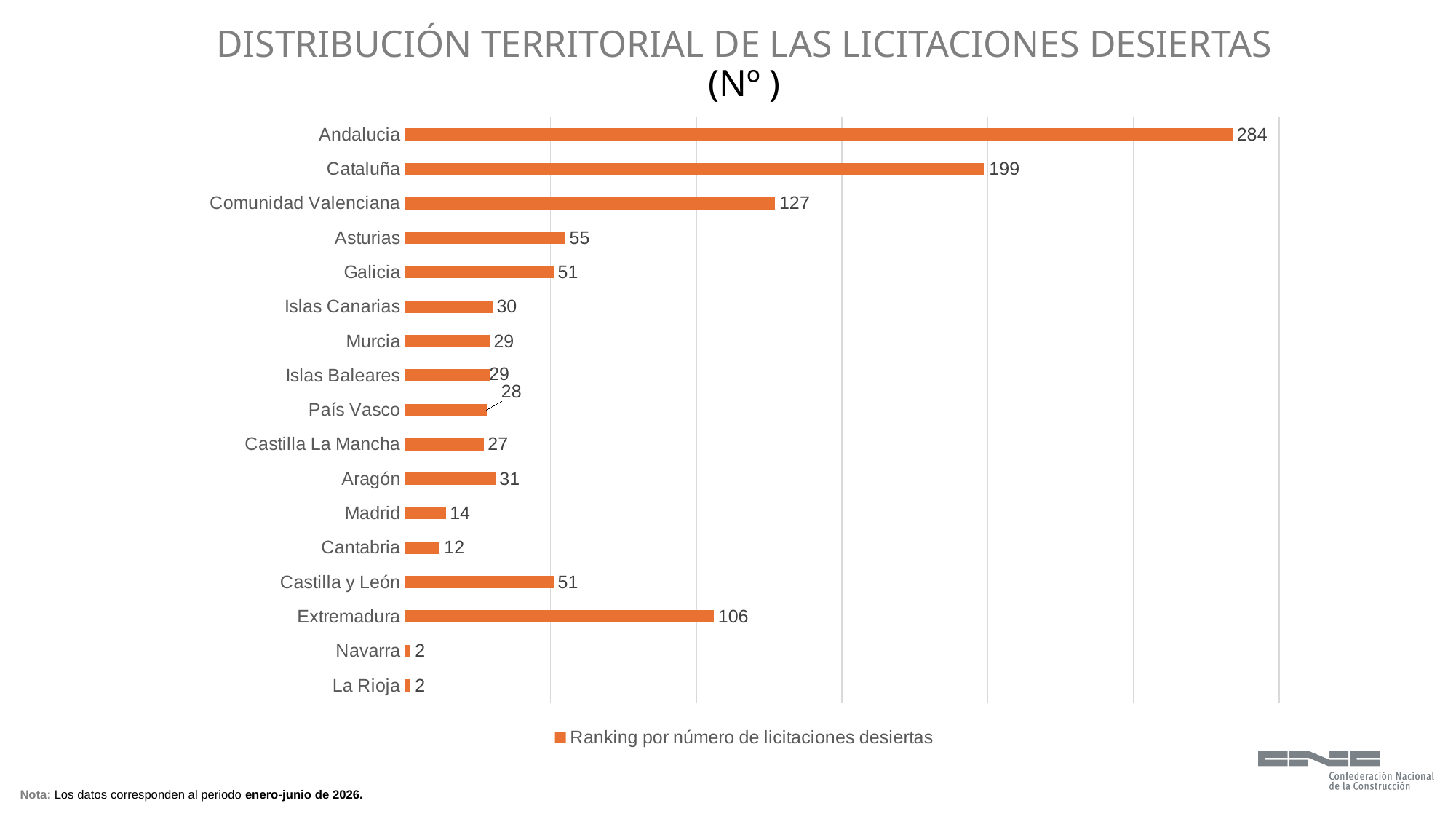
What is the value for Comunidad Valenciana? 127 What is the difference between the values for Extremadura and Asturias? 51 How many series does the legend list? 1 What kind of chart is shown on the slide? bar chart What is the value for País Vasco? 28 Which is larger, the value for Aragón or the value for Islas Canarias? Aragón Which region has the highest number of licitaciones desiertas? Andalucia What is the legend entry for the series in the chart? Ranking por número de licitaciones desiertas What is the value for Extremadura? 106 What is the difference between the values for Andalucia and Cataluña? 85 How many regions are shown in the chart? 17 What is the value for Andalucia? 284